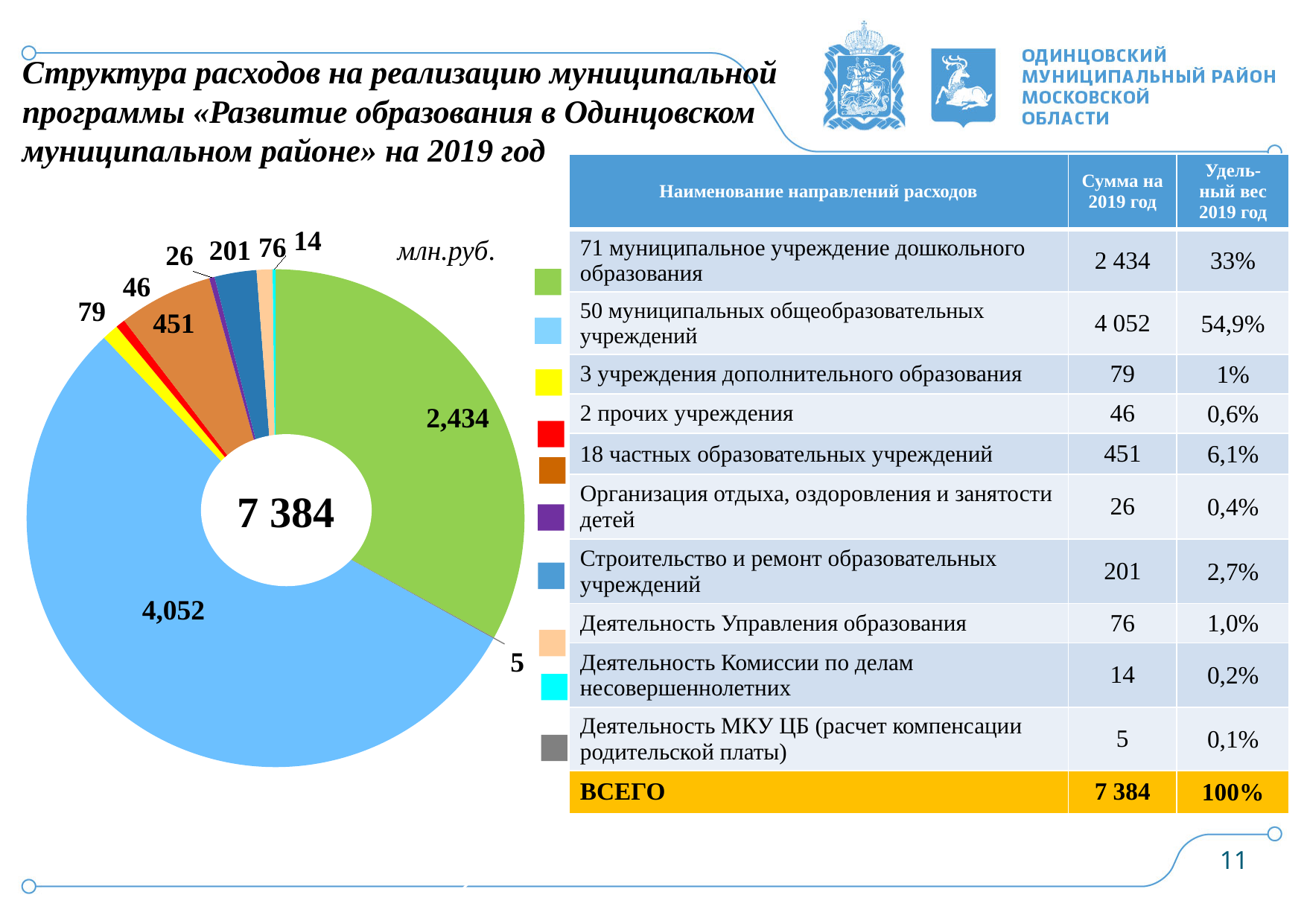
What value is shown on the chart for 'Строительство и ремонт образовательных учреждений'? 201 Which category has the smallest slice in the chart? Деятельность МКУ ЦБ (расчет компенсации родительской платы) What value is shown on the chart for the slice '50 муниципальных общеобразовательных учреждений'? 4,052 What value is shown on the chart for the slice '71 муниципальное учреждение дошкольного образования'? 2,434 What total is shown in the centre of the doughnut chart? 7 384 What share of the total does '50 муниципальных общеобразовательных учреждений' account for, according to the table? 54,9% Which category has the largest slice in the chart? 50 муниципальных общеобразовательных учреждений What is the difference between the values for '50 муниципальных общеобразовательных учреждений' (4,052) and '71 муниципальное учреждение дошкольного образования' (2,434)? 1,618 How many slices does the doughnut chart have? 10 What kind of chart is shown on the slide? Pie (doughnut) chart Which is larger: the value for '18 частных образовательных учреждений' or for 'Строительство и ремонт образовательных учреждений'? 18 частных образовательных учреждений In what units are the chart values given? млн.руб.